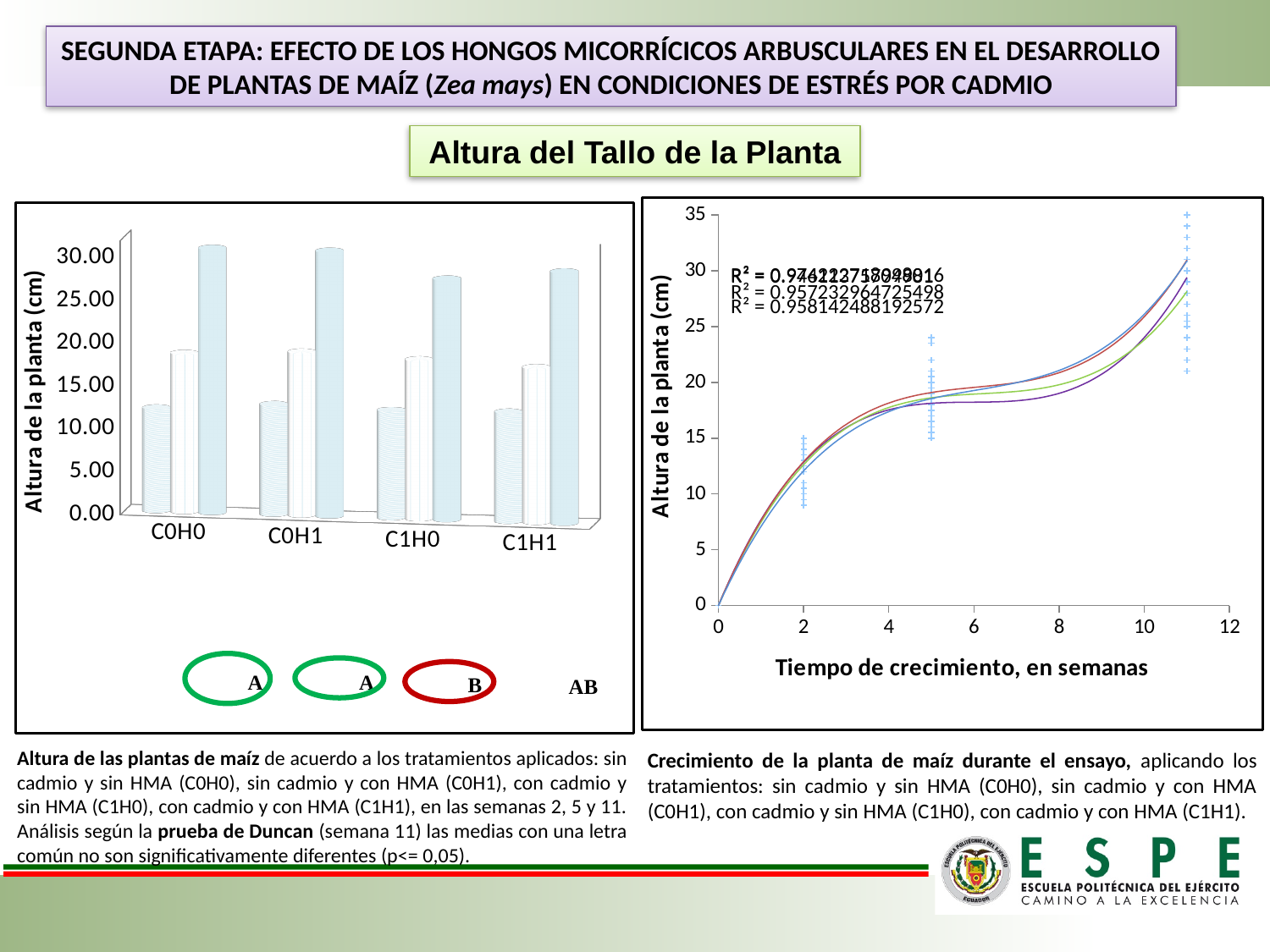
How many treatment categories are shown on the x axis of the left bar chart? 4 What is the highest tick value on the x axis of the right chart? 12 What kind of chart is the left chart on the slide? bar chart In the right chart, do the fitted curves rise or fall as time in weeks increases? rise In the left bar chart, is the middle bar for C1H1 greater or less than 20.00? less In the left bar chart, is the tallest bar for C1H1 greater or less than 25.00? greater In the left bar chart, is the tallest bar for C0H0 greater or less than 25.00? greater What is the highest tick value shown on the y axis of the left bar chart? 30.00 What is the x axis title of the right chart? Tiempo de crecimiento, en semanas What is the highest tick value on the y axis of the right chart? 35